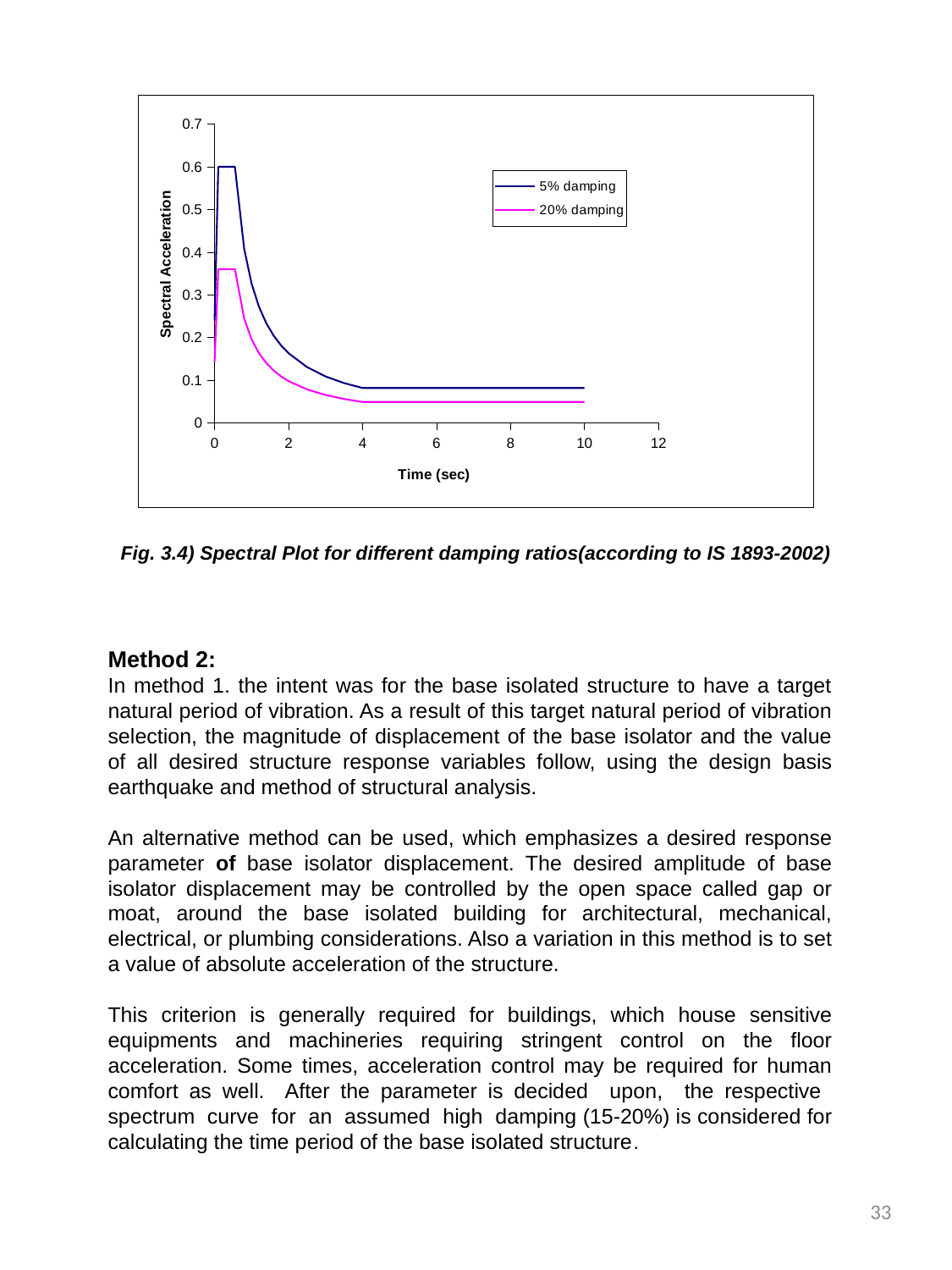
Which series reaches the higher peak spectral acceleration? 5% damping What is the label of the vertical axis of the chart? Spectral Acceleration After reaching their peaks, do the spectral acceleration curves rise or fall as time increases? fall Is the peak value of the 20% damping curve greater or less than 0.3? greater Is the value of the 5% damping curve at a time of 8 sec greater or less than 0.1? less Which series has the lower spectral acceleration at a time of 2 sec? 20% damping What is the peak spectral acceleration reached by the 5% damping curve? 0.6 What are the two series named in the chart legend? 5% damping and 20% damping Is the peak value of the 20% damping curve greater or less than 0.4? less How many series does the chart legend list? 2 At a time of 2 sec, which series has the larger spectral acceleration, 5% damping or 20% damping? 5% damping What type of chart is shown on the slide? line chart